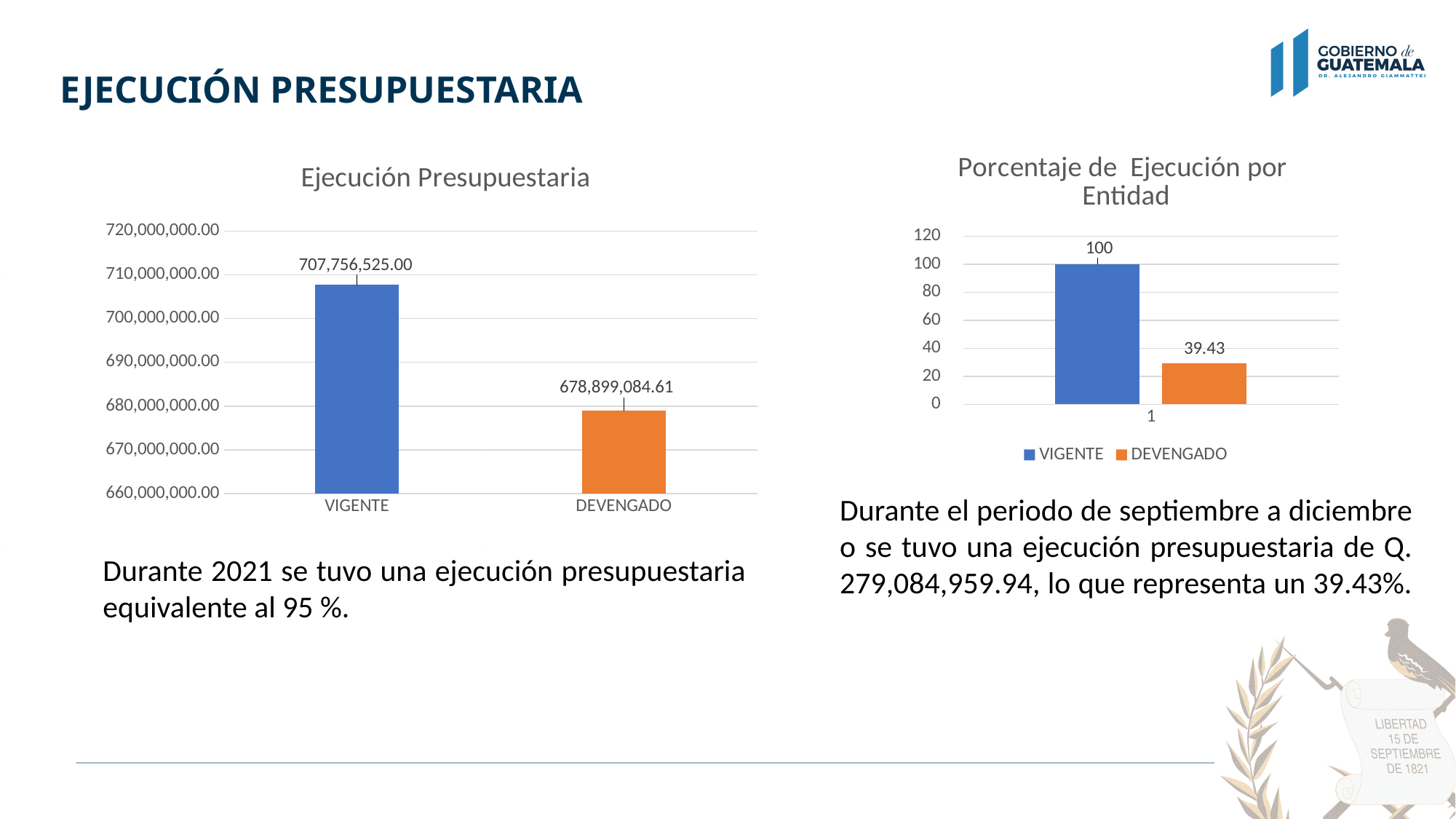
What kind of chart is the 'Ejecución Presupuestaria' chart? Bar chart In the 'Porcentaje de Ejecución por Entidad' chart, what is the difference between VIGENTE and DEVENGADO? 60.57 In the 'Ejecución Presupuestaria' chart, what is the value for DEVENGADO? 678,899,084.61 In the 'Porcentaje de Ejecución por Entidad' chart, how many series does the legend list? 2 In the 'Ejecución Presupuestaria' chart, which category has the highest value? VIGENTE In the 'Ejecución Presupuestaria' chart, how many categories are shown? 2 In the 'Porcentaje de Ejecución por Entidad' chart, what is the value for DEVENGADO? 39.43 In the 'Ejecución Presupuestaria' chart, what is the value for VIGENTE? 707,756,525.00 In the 'Ejecución Presupuestaria' chart, what is the difference between VIGENTE and DEVENGADO? 28,857,440.39 In the 'Porcentaje de Ejecución por Entidad' chart, what is the value for VIGENTE? 100 In the 'Porcentaje de Ejecución por Entidad' chart, which series has the lowest value? DEVENGADO In the 'Porcentaje de Ejecución por Entidad' chart, what colour is the VIGENTE bar? Blue